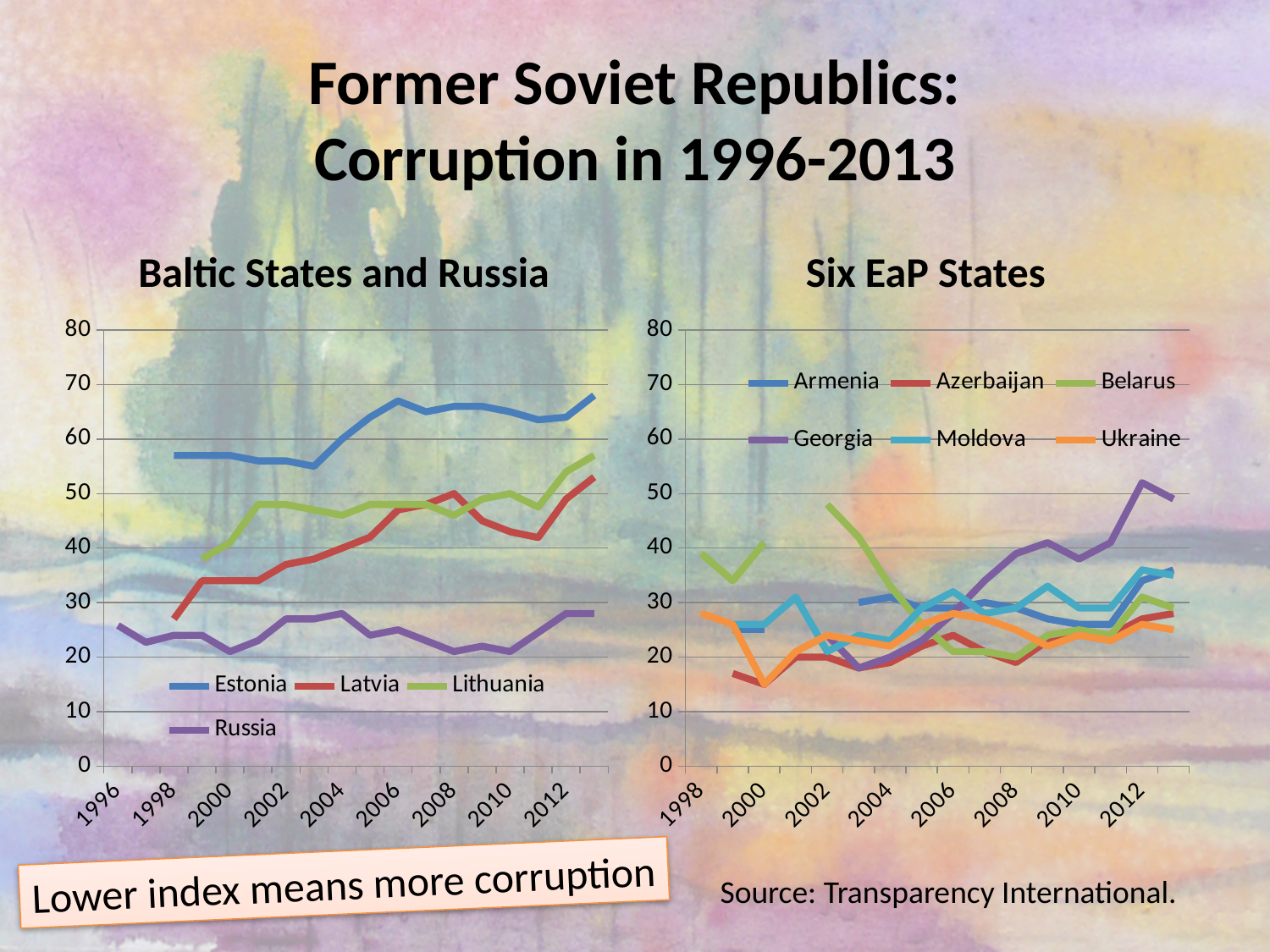
In the 'Baltic States and Russia' chart, is the value for Estonia in 2013 greater or less than 60? greater In the 'Six EaP States' chart, which country has the highest index in 2012? Georgia In the 'Six EaP States' chart, does the value for Georgia rise or fall between 2003 and 2012? rise How many series does the legend of the 'Baltic States and Russia' chart list? 4 What source is cited for the data on the slide? Transparency International In the 'Six EaP States' chart, which is larger in 2013, the value for Georgia or the value for Ukraine? Georgia In the 'Baltic States and Russia' chart, which country has the lowest index in 2013? Russia In the 'Baltic States and Russia' chart, is the value for Russia in 2013 greater or less than 30? less How many series does the legend of the 'Six EaP States' chart list? 6 In the 'Six EaP States' chart, is the value for Georgia in 2012 greater or less than 50? greater What kind of chart is the 'Baltic States and Russia' chart? line chart In the 'Baltic States and Russia' chart, which country has the highest index in 2013? Estonia